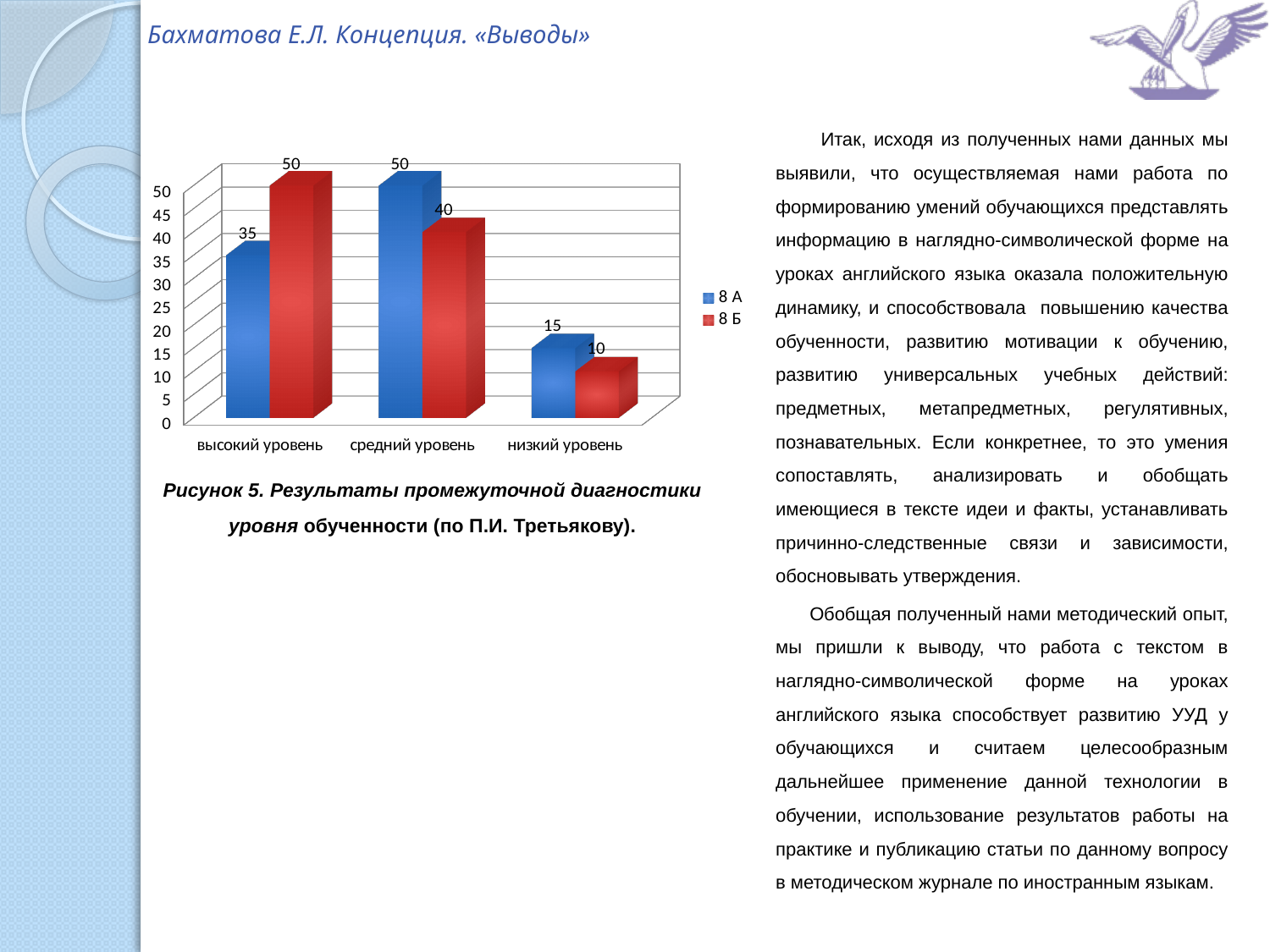
How many series does the legend list? 2 What is the difference between 8 Б and 8 А at высокий уровень? 15 Which category has the lowest value for 8 Б? низкий уровень What is the value for 8 А at высокий уровень? 35 What is the value for 8 Б at высокий уровень? 50 What kind of chart is shown on the slide? bar chart Which is larger at средний уровень, 8 А or 8 Б? 8 А What colour represents the 8 Б series? red How many categories are shown on the x axis? 3 What is the value for 8 А at низкий уровень? 15 Which category has the highest value for 8 А? средний уровень What is the value for 8 Б at средний уровень? 40